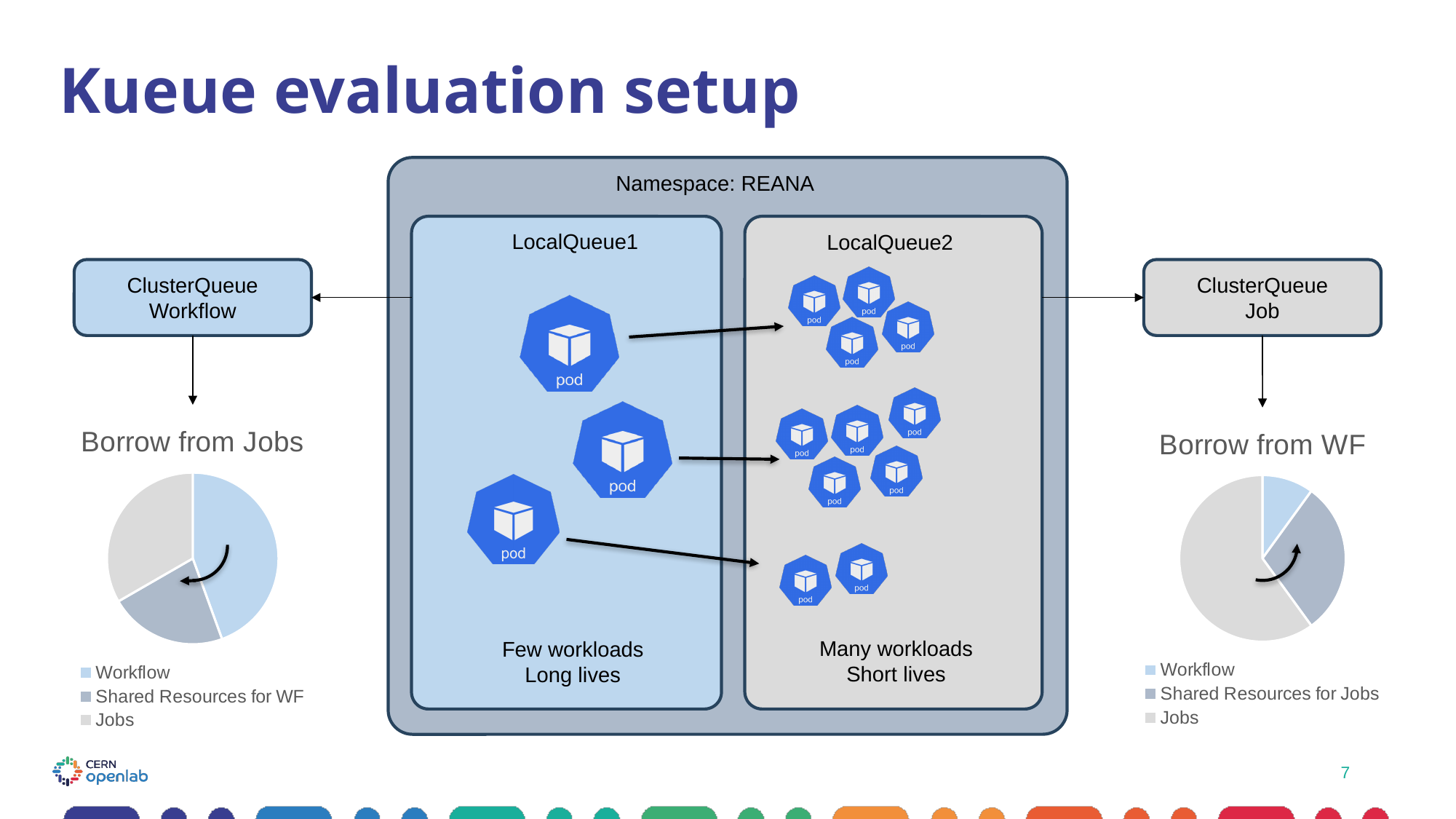
What is the title of the pie chart on the left of the slide? Borrow from Jobs How many slices does the "Borrow from WF" pie chart have? 3 What kind of chart is the "Borrow from WF" chart on the right of the slide? pie chart How many entries does the legend of the "Borrow from WF" chart list? 3 What kind of chart is the "Borrow from Jobs" chart on the left of the slide? pie chart How many entries does the legend of the "Borrow from Jobs" chart list? 3 In the "Borrow from WF" chart, which slice is larger: Jobs or Workflow? Jobs In the "Borrow from Jobs" chart, which slice is larger: Workflow or Shared Resources for WF? Workflow In the "Borrow from Jobs" chart, which slice is the smallest? Shared Resources for WF In the "Borrow from WF" chart, which slice is the smallest? Workflow What are the legend entries of the "Borrow from WF" chart? Workflow, Shared Resources for Jobs, Jobs In the "Borrow from WF" chart, which slice is the largest? Jobs